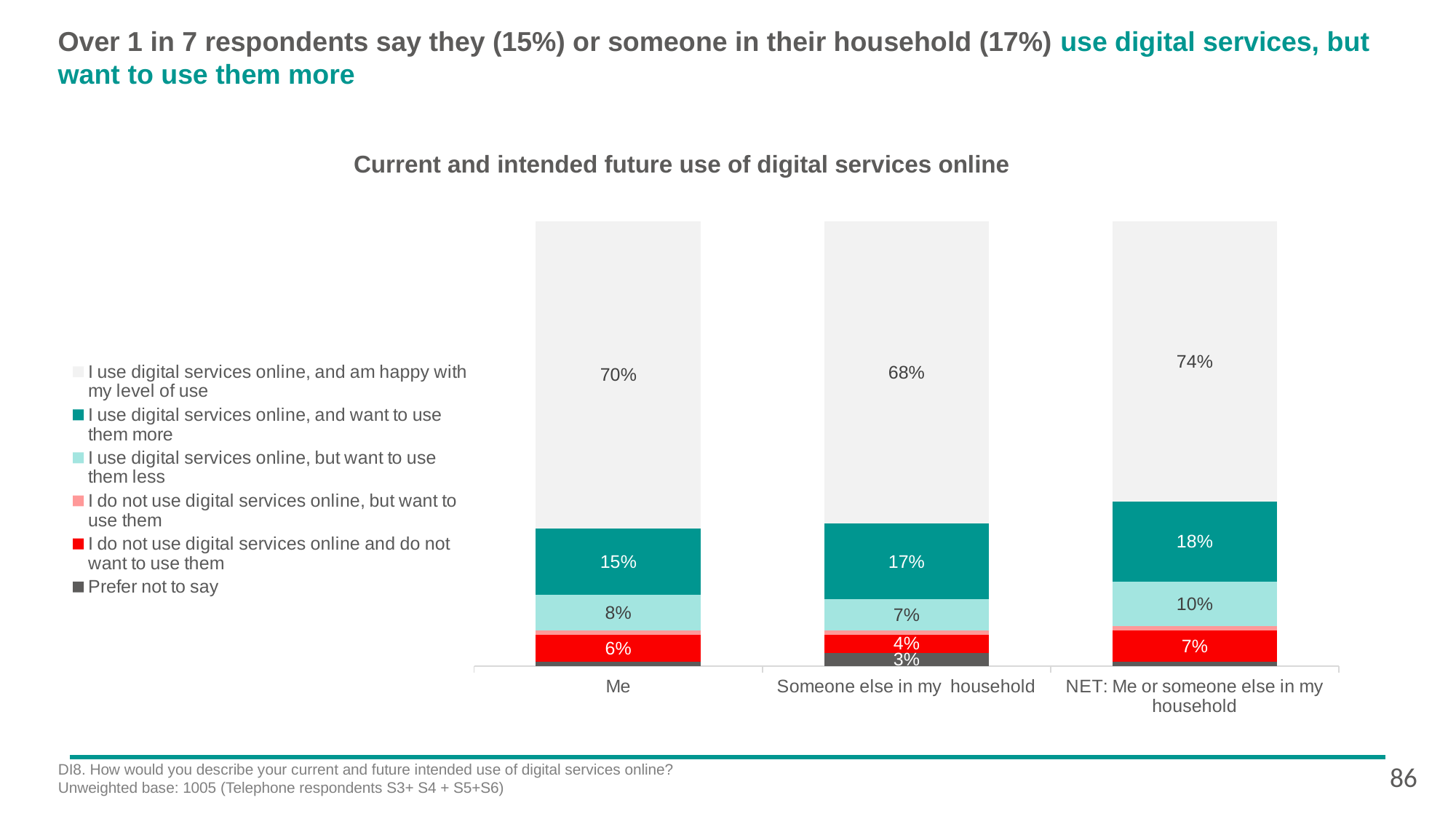
What is the title of the chart? Current and intended future use of digital services online What percentage of respondents in the 'Me' category use digital services online and are happy with their level of use? 70% What is the value for 'I use digital services online, but want to use them less' in the 'NET: Me or someone else in my household' category? 10% What is the value for 'I do not use digital services online and do not want to use them' in the 'Me' category? 6% What is the difference between the 'I use digital services online, and want to use them more' values for 'NET: Me or someone else in my household' and 'Me'? 3% How many categories are shown on the x axis? 3 Which category has the highest value for 'I use digital services online, and am happy with my level of use'? NET: Me or someone else in my household How many series does the legend list? 6 Which is larger: the 'I use digital services online, but want to use them less' value for 'Me' or for 'Someone else in my household'? Me What is the value for 'Prefer not to say' in the 'Someone else in my household' category? 3% What is the value for 'I use digital services online, and want to use them more' in the 'Someone else in my household' category? 17% What kind of chart is shown on the slide? Stacked bar chart